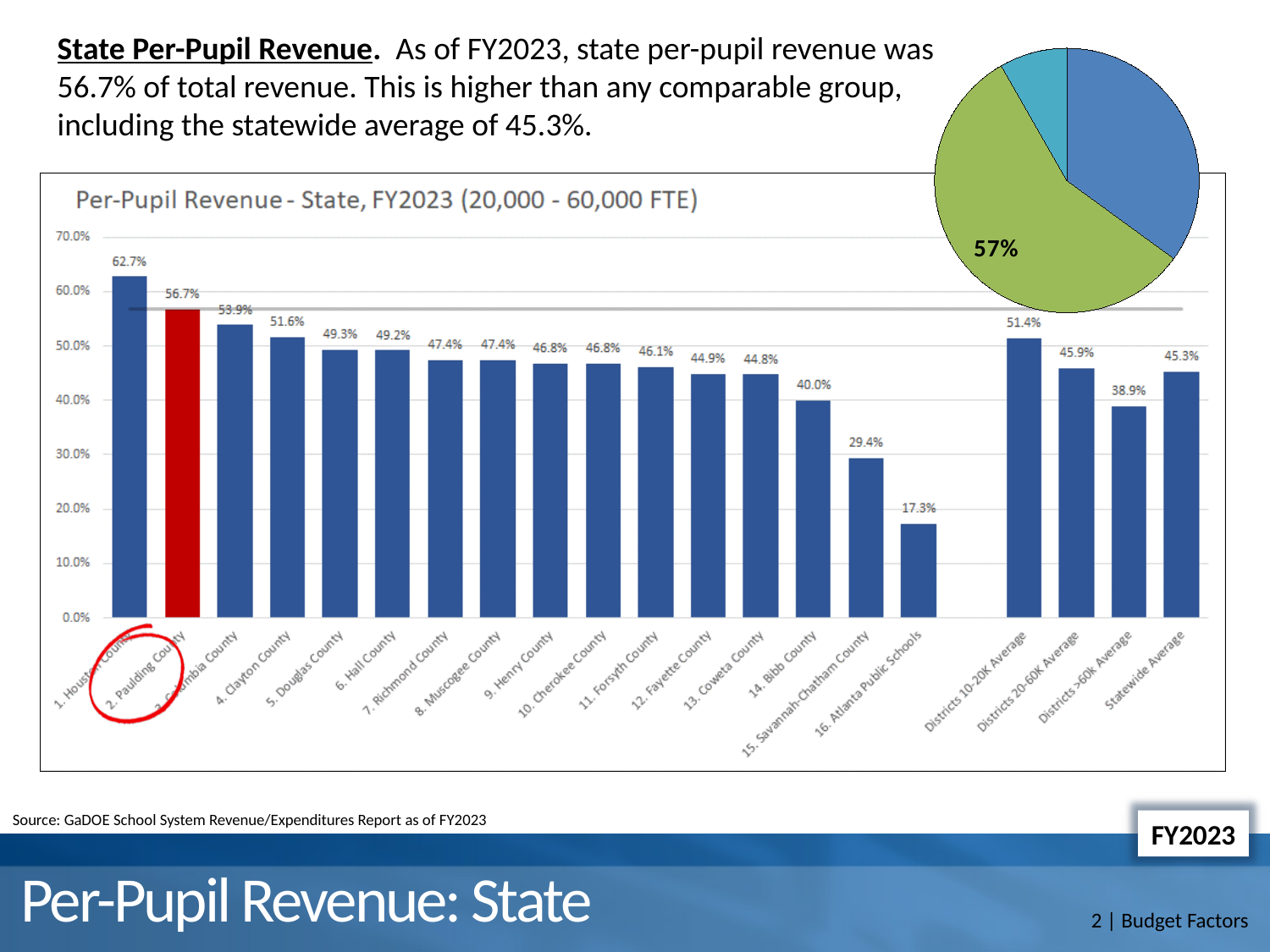
In the bar chart, what is the value for the Statewide Average? 45.3% In the bar chart, which category has the highest value? 1. Houston County In the pie chart in the top right of the slide, what percentage is printed on the largest slice? 57% In the bar chart, what is the difference between the values for 1. Houston County and 2. Paulding County? 6.0% In the bar chart, which category has the lowest value? 16. Atlanta Public Schools How many bars are plotted in the bar chart? 20 In the bar chart, what is the value for 16. Atlanta Public Schools? 17.3% In the bar chart, is the value for 15. Savannah-Chatham County greater or less than 30.0%? less In the bar chart, which is larger: the value for 14. Bibb County or the value for Districts >60K Average? 14. Bibb County What kind of chart is the chart titled "Per-Pupil Revenue - State, FY2023 (20,000 - 60,000 FTE)"? bar chart In the bar chart, which bar is coloured red rather than blue? 2. Paulding County In the bar chart titled "Per-Pupil Revenue - State, FY2023 (20,000 - 60,000 FTE)", what is the value for 2. Paulding County? 56.7%